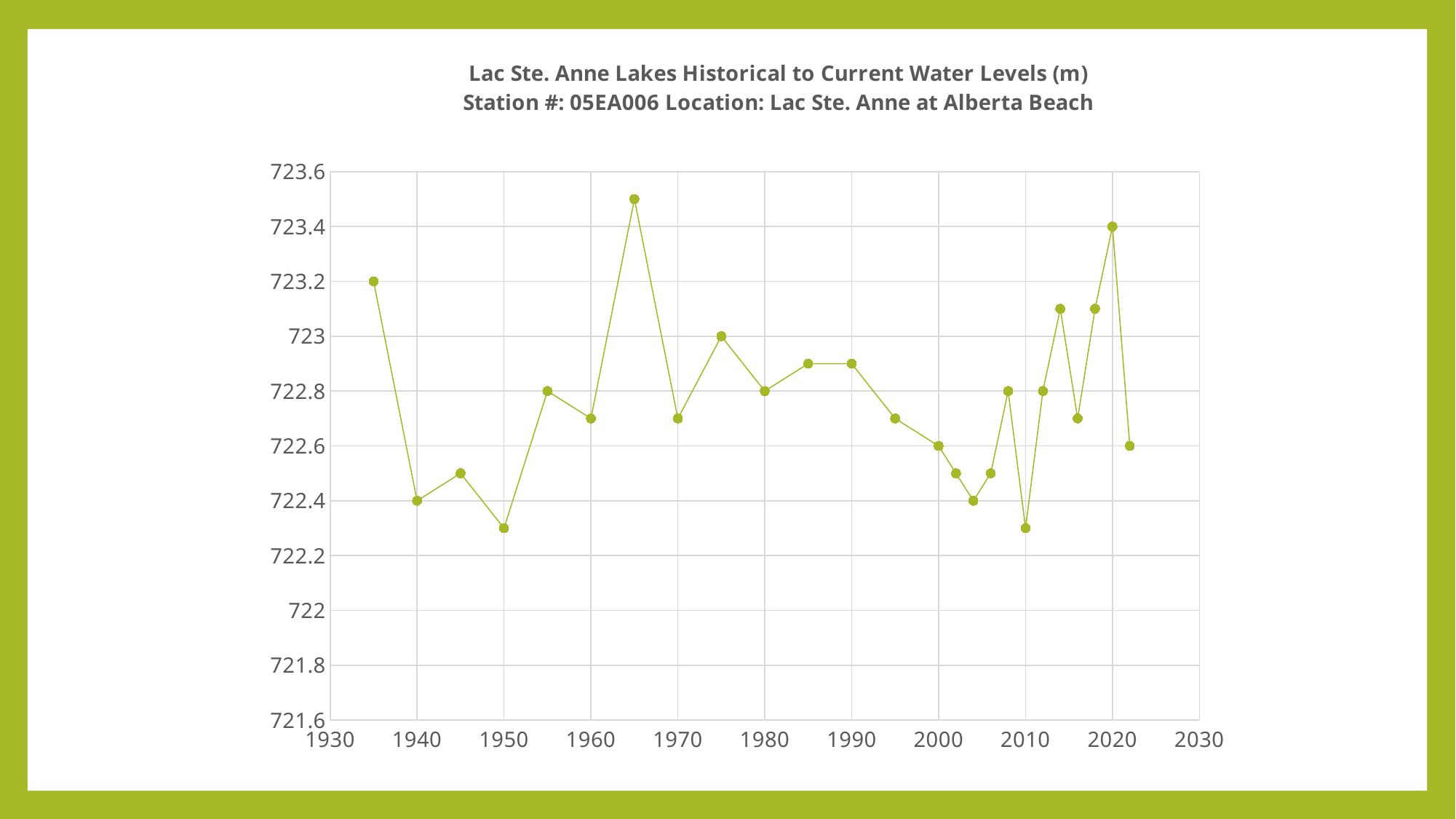
Does the water level rise or fall between 1935 and 1940? fall What station number is given in the chart title? 05EA006 What kind of chart is shown on the slide? line chart Which year has the highest water level? 1965 Which is larger, the water level for 1935 or for 1940? 1935 Is the water level for 2010 greater or less than 722.4? less Is the water level for 1965 greater or less than 723.4? greater What is the difference between the water levels for 2020 and 2022? 0.8 What is the water level for 2020? 723.4 What is the water level for 1935? 723.2 What is the water level for 1975? 723 What is the water level for 1940? 722.4